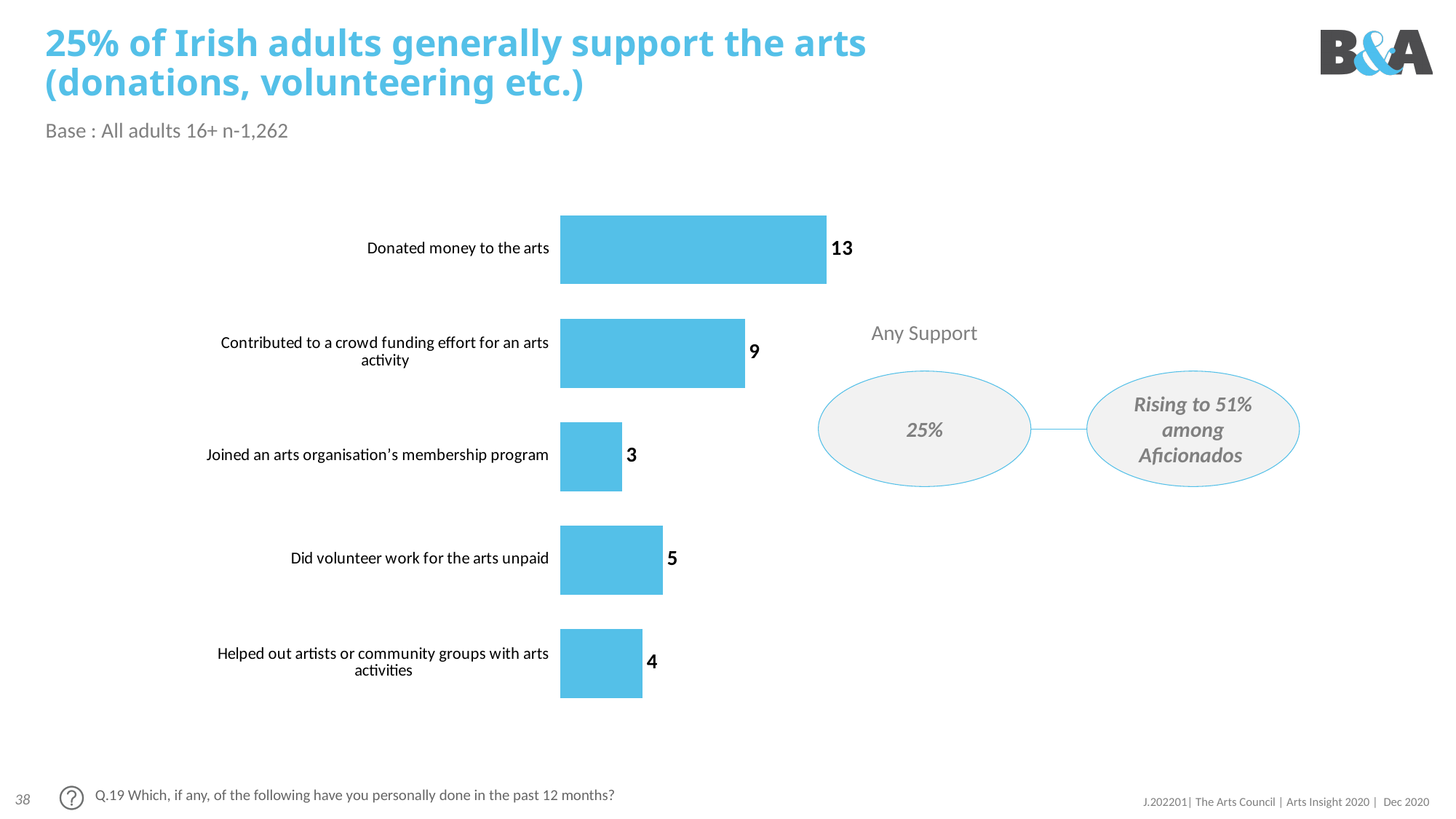
What is the value for 'Helped out artists or community groups with arts activities'? 4 What is the value for 'Did volunteer work for the arts unpaid'? 5 What percentage is shown in the 'Any Support' oval next to the chart? 25% What is the value for 'Contributed to a crowd funding effort for an arts activity'? 9 Which category has the lowest value? Joined an arts organisation's membership program What kind of chart is shown on the slide? Bar chart Which category has the highest value? Donated money to the arts What is the difference between the values for 'Donated money to the arts' and 'Contributed to a crowd funding effort for an arts activity'? 4 Which is larger: the value for 'Did volunteer work for the arts unpaid' or 'Helped out artists or community groups with arts activities'? Did volunteer work for the arts unpaid How many categories are shown in the bar chart? 5 What is the value for 'Joined an arts organisation's membership program'? 3 What is the value for 'Donated money to the arts'? 13